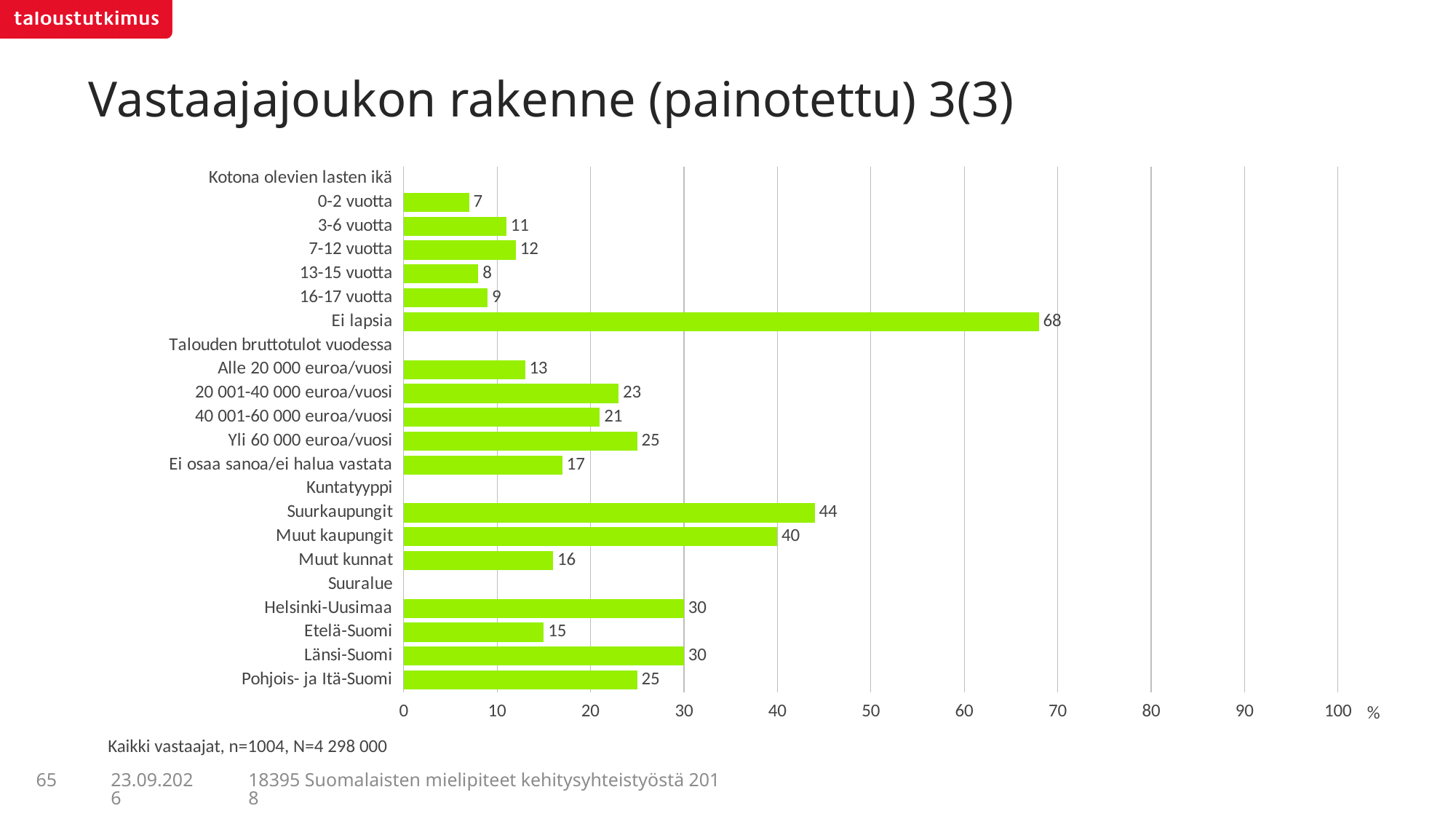
What is the value for Ei lapsia? 68 Which category has the highest value in the chart? Ei lapsia What is the title of the slide? Vastaajajoukon rakenne (painotettu) 3(3) What is the difference between the values for Suurkaupungit and Muut kunnat? 28 What is the value for Suurkaupungit? 44 What kind of chart is shown on the slide? bar chart What is the value for Pohjois- ja Itä-Suomi? 25 How many bars are plotted in the chart? 18 Is the value for Muut kaupungit greater or less than 30? greater What is the value for 20 001-40 000 euroa/vuosi? 23 Which category has the lowest value in the chart? 0-2 vuotta Which is larger, the value for Yli 60 000 euroa/vuosi or the value for 40 001-60 000 euroa/vuosi? Yli 60 000 euroa/vuosi